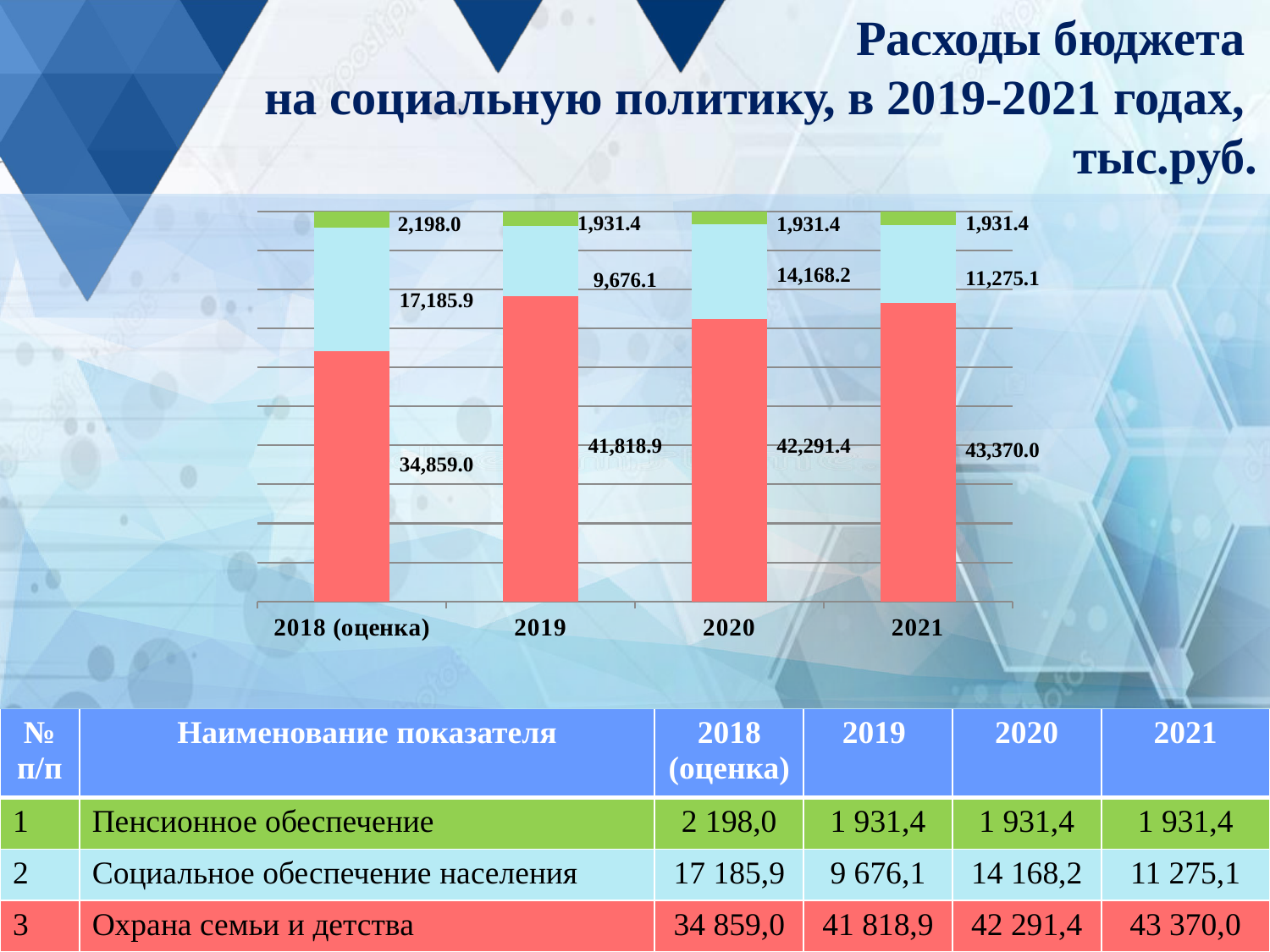
What is the total of the stacked bar for 2020? 58,391.0 What is the value of the light blue segment (Социальное обеспечение населения) for 2020 in the chart? 14,168.2 What is the title of the chart on the slide? Расходы бюджета на социальную политику, в 2019-2021 годах, тыс.руб. In which year is the red segment (Охрана семьи и детства) the largest? 2021 Which year has the larger light blue segment (Социальное обеспечение населения): 2020 or 2021? 2020 In which year is the light blue segment (Социальное обеспечение населения) the smallest? 2019 What is the value of the red segment (Охрана семьи и детства) for 2019 in the chart? 41,818.9 What kind of chart is shown on the slide? Stacked bar chart Does the red segment (Охрана семьи и детства) rise or fall from 2018 (оценка) to 2021? Rises What is the value of the green segment (Пенсионное обеспечение) for 2018 (оценка) in the chart? 2,198.0 How many year categories are shown on the x axis of the chart? 4 By how much does the red segment (Охрана семьи и детства) for 2021 exceed that for 2018 (оценка)? 8,511.0